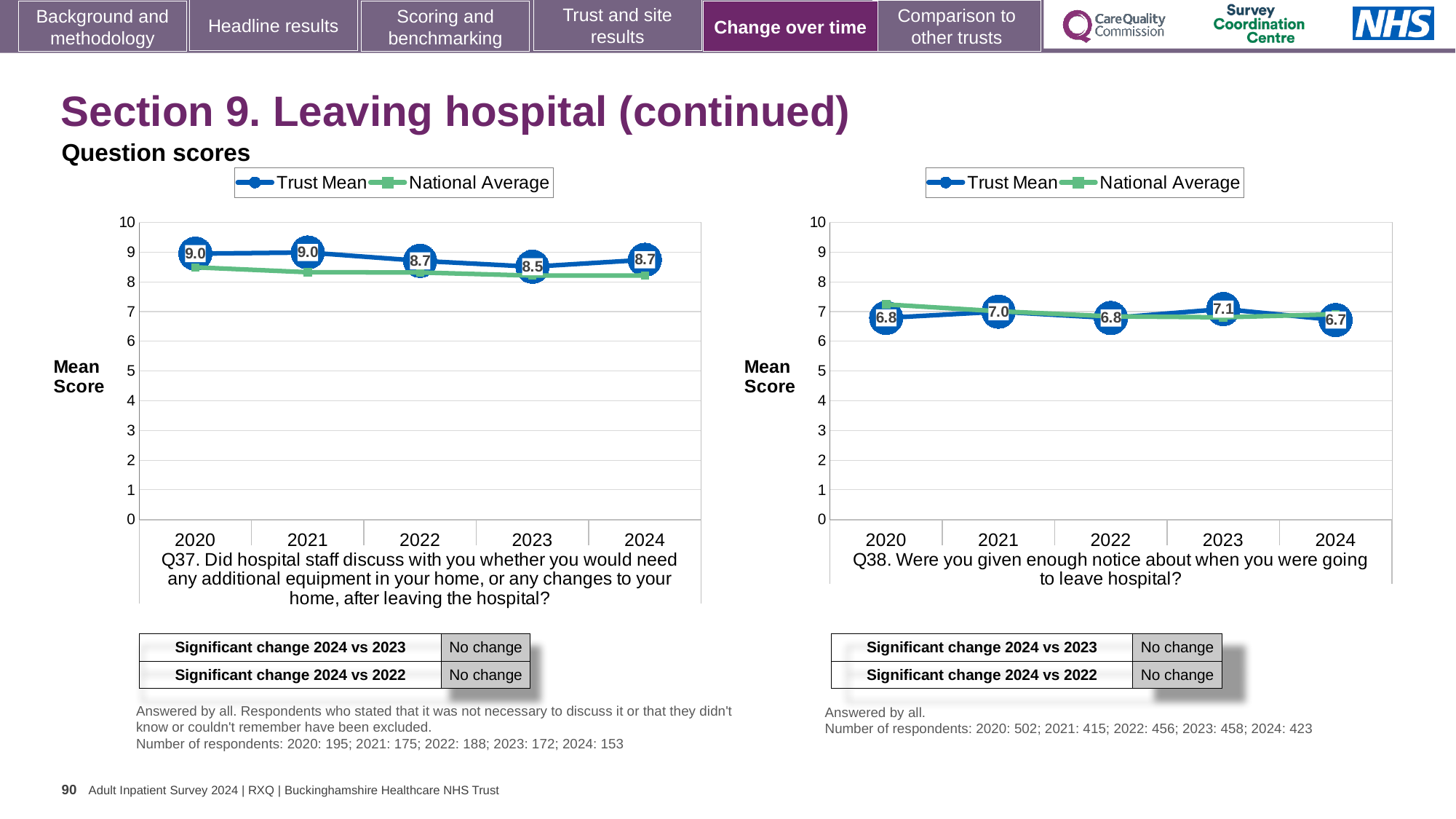
In the Q38 chart on the right, what is the Trust Mean score for 2021? 7.0 In the Q37 chart on the left, what is the difference between the Trust Mean scores for 2020 and 2024? 0.3 In the Q38 chart on the right, which year has the lowest Trust Mean score? 2024 In the Q37 chart on the left, is the Trust Mean score higher in 2021 or in 2023? 2021 In the Q38 chart on the right, what is the difference between the Trust Mean scores for 2023 and 2024? 0.4 In the Q37 chart on the left, what is the Trust Mean score for 2023? 8.5 In the Q37 chart on the left, which year has the lowest Trust Mean score? 2023 How many series does the legend of the Q38 chart on the right list? 2 How many years are plotted on the x axis of the Q37 chart on the left? 5 In the Q38 chart on the right, is the National Average value for 2020 greater or less than 8? less In the Q38 chart on the right, which year has the highest Trust Mean score? 2023 In the Q37 chart on the left, is the National Average value for 2020 greater or less than 8? greater